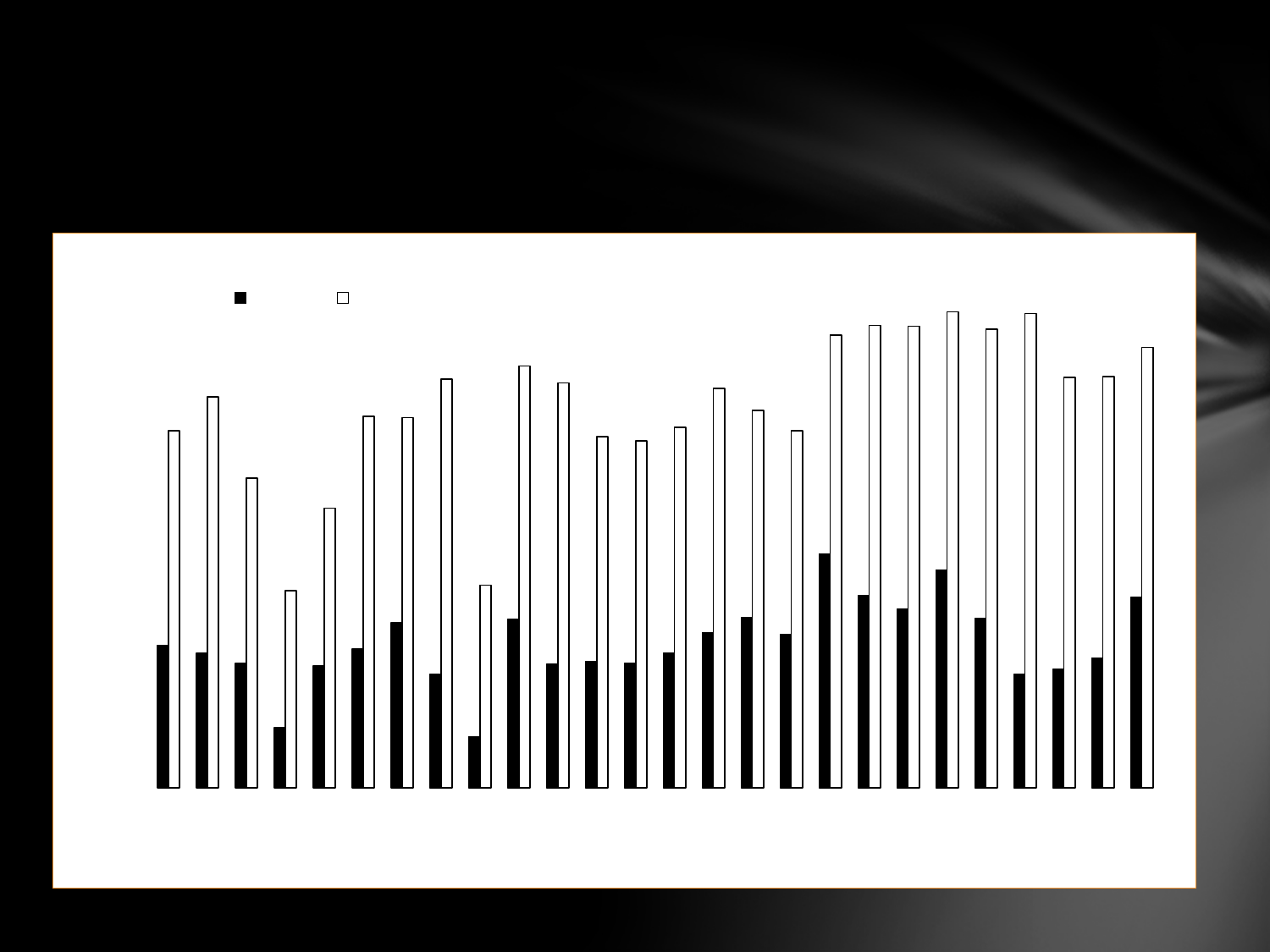
What two colours are used for the bars in the chart? black and white How many categories (pairs of bars) are plotted in the chart? 26 How many series does the legend list? 2 Are the bars in the chart vertical or horizontal? vertical Which series has the taller bars in every category, the black series or the white series? the white series What kind of chart is shown on the slide? bar chart